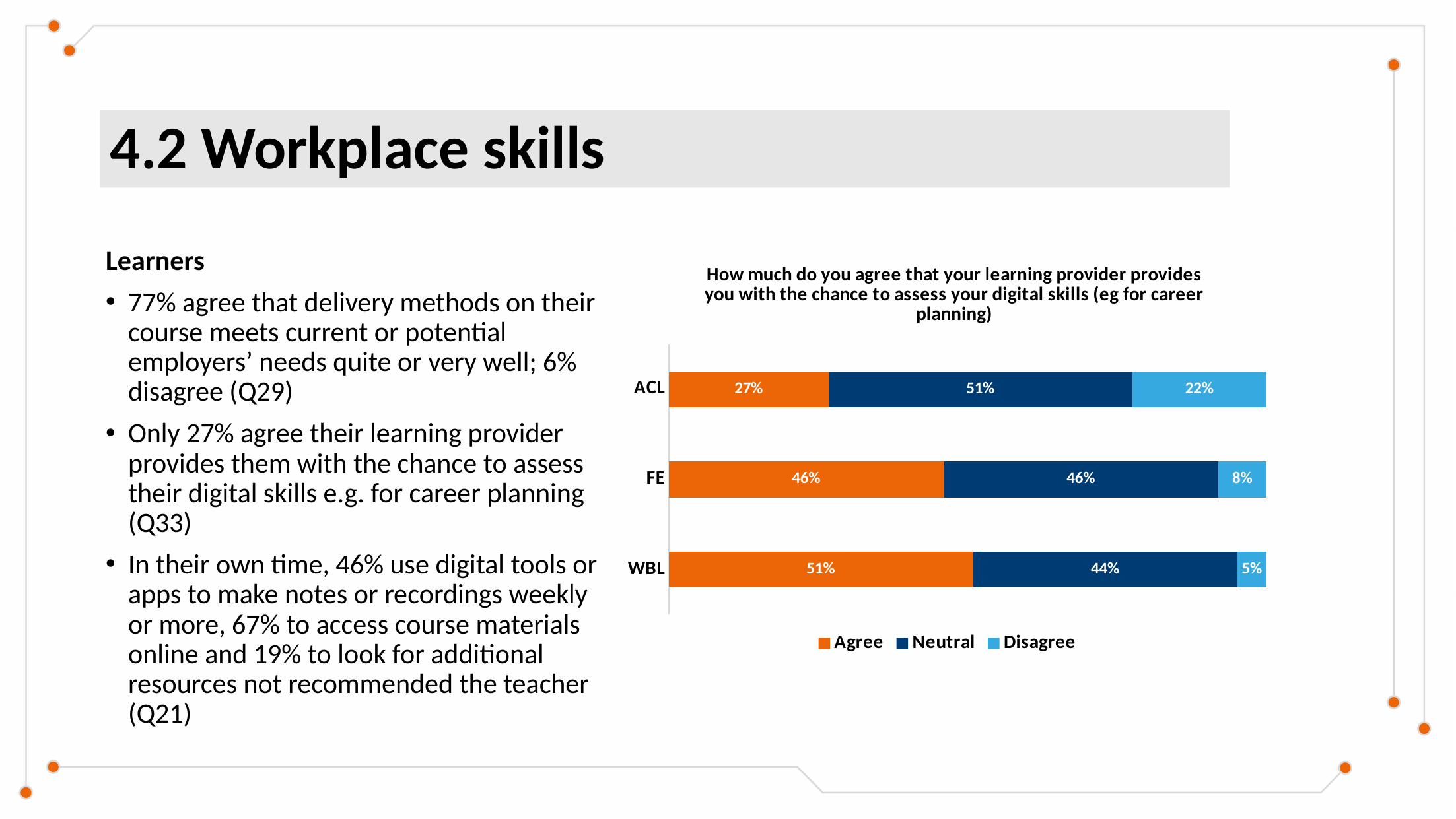
What is the total of the stacked bar for FE? 100% How many categories are shown on the chart? 3 What is the Disagree value for WBL in the chart? 5% What is the difference between the Agree values for WBL and ACL? 24% Which is larger: the Disagree value for ACL or the Disagree value for FE? ACL Which category has the highest Agree value? WBL Which category has the lowest Disagree value? WBL Which series is shown in orange in the chart? Agree How many series does the legend list? 3 What percentage of ACL learners agree that their learning provider gives them the chance to assess their digital skills? 27% What kind of chart is shown on the slide? Stacked bar chart What is the Neutral value for FE in the chart? 46%